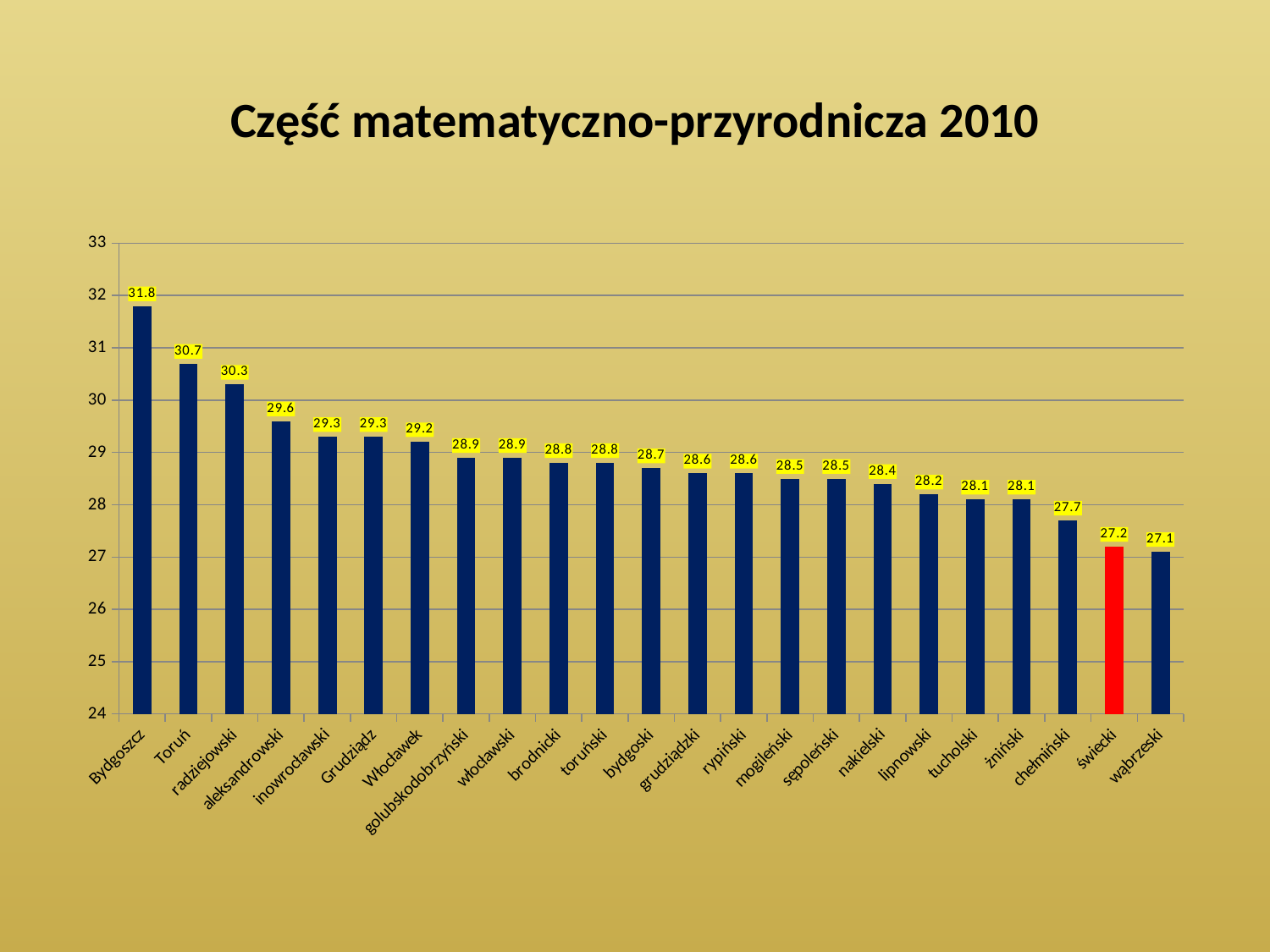
How many categories are shown on the x axis? 23 What is the value for świecki? 27.2 What kind of chart is shown on the slide? bar chart Which is larger, the value for radziejowski or the value for chełmiński? radziejowski Do the values rise or fall from left to right along the x axis? fall Which category's bar is coloured red instead of dark blue? świecki Which category has the lowest value? wąbrzeski What is the value for Bydgoszcz? 31.8 What is the value for nakielski? 28.4 Which category has the highest value? Bydgoszcz What is the value for aleksandrowski? 29.6 What is the difference between the values for Bydgoszcz and Toruń? 1.1